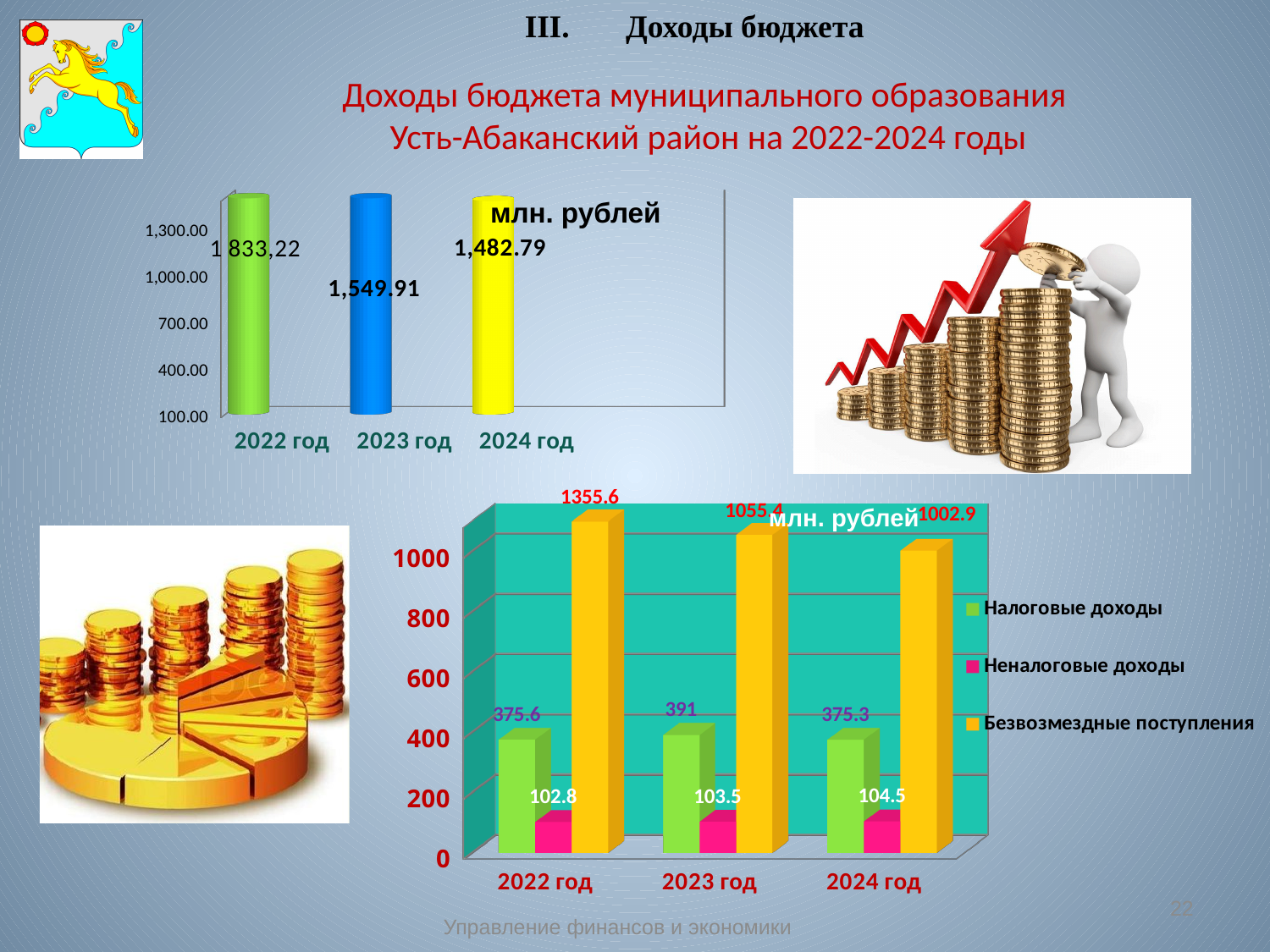
In the bottom chart, what is the difference between Безвозмездные поступления in 2022 год and 2024 год? 352.7 In the top-left chart, how many bars (years) are shown? 3 In the top-left chart, what is the value for 2023 год? 1,549.91 In the bottom chart, how many series does the legend list? 3 In the bottom chart, do the values for Безвозмездные поступления rise or fall from 2022 год to 2024 год? fall In the bottom chart, what is the value of Безвозмездные поступления for 2022 год? 1355.6 In the bottom chart, what is the value of Налоговые доходы for 2023 год? 391 In the top-left chart, what is the value for 2024 год? 1,482.79 In the bottom chart, which series is shown in yellow? Безвозмездные поступления In the bottom chart, what is the value of Неналоговые доходы for 2024 год? 104.5 In the bottom chart, which year has the highest value for Безвозмездные поступления? 2022 год What kind of chart is the top-left chart? bar chart